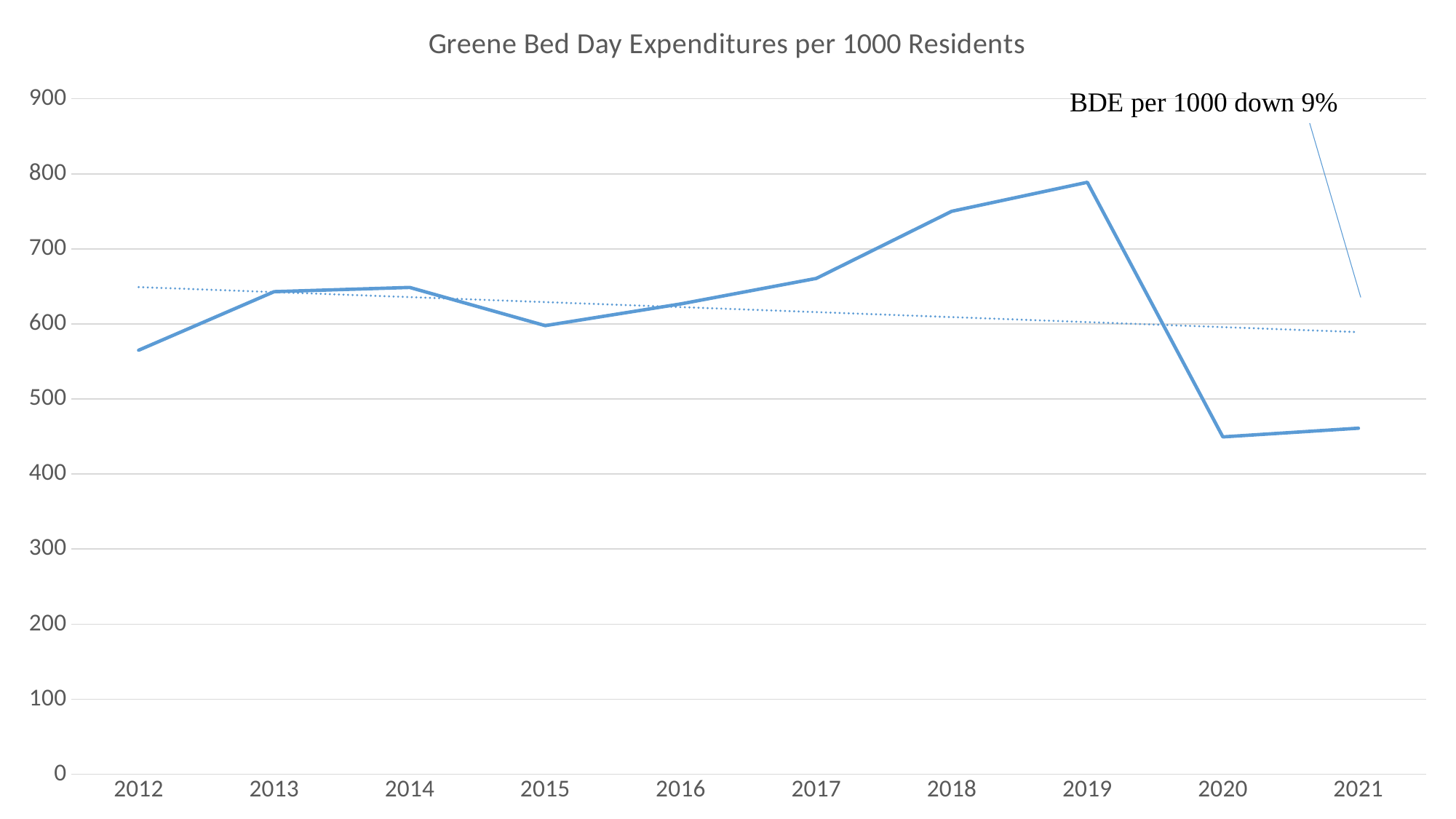
What kind of chart is shown on the slide? line chart What does the annotation text on the chart say? BDE per 1000 down 9% What is the title of the chart? Greene Bed Day Expenditures per 1000 Residents Is the value for 2020 greater or less than 500? less Is the value for 2018 greater or less than 700? greater Is the value for 2019 greater or less than 700? greater In which year is the value highest? 2019 Which year has the larger value, 2017 or 2018? 2018 Does the value rise or fall from 2012 to 2013? rise Does the value rise or fall from 2019 to 2020? fall How many years are plotted along the x axis? 10